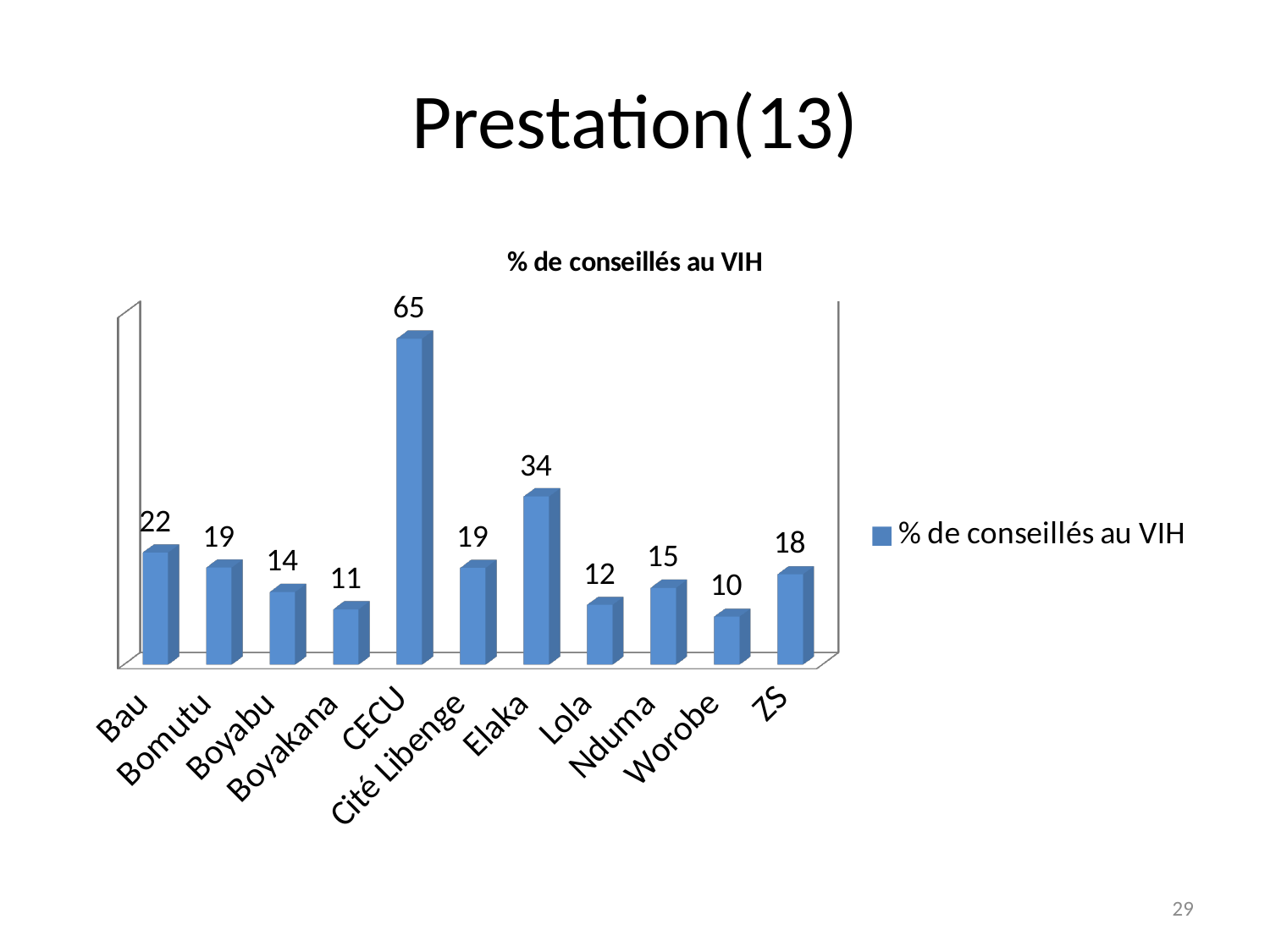
What is the title of the chart? % de conseillés au VIH What is the value for CECU? 65 Which category has the lowest value? Worobe What is the value for Cité Libenge? 19 What kind of chart is shown on the slide? bar chart What is the value for Elaka? 34 Which is larger, the value for Bau or the value for ZS? Bau How many series does the legend list? 1 Which category has the highest value? CECU What is the difference between the values for CECU and Elaka? 31 How many categories are shown on the x axis? 11 What is the value for Worobe? 10